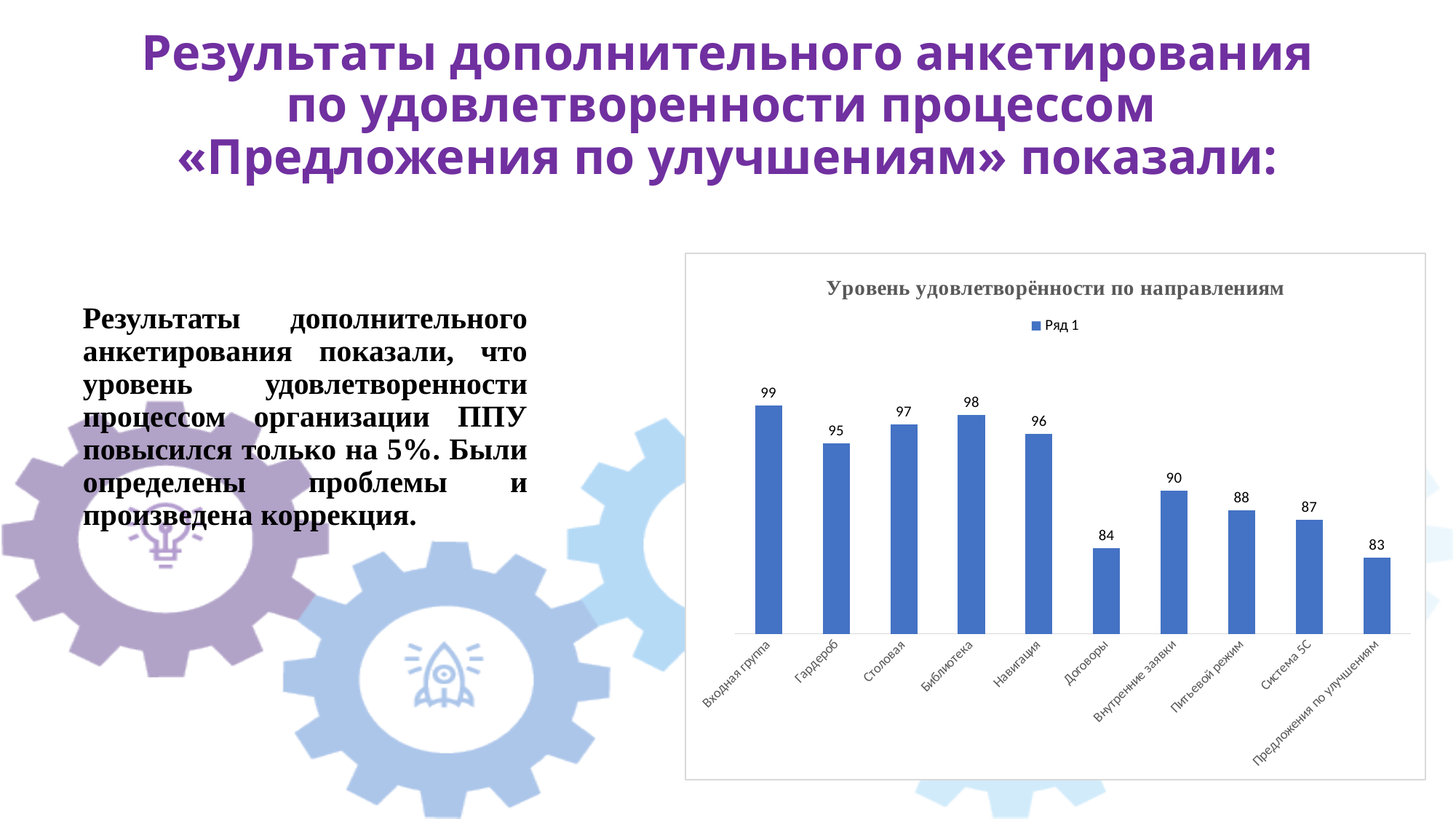
What is the difference between the values for Входная группа and Предложения по улучшениям? 16 Which is larger, the value for Библиотека or the value for Навигация? Библиотека How many series does the legend list? 1 What is the title of the chart? Уровень удовлетворённости по направлениям What is the value for Договоры? 84 What is the value for Предложения по улучшениям? 83 Which category has the highest value? Входная группа Which category has the lowest value? Предложения по улучшениям What kind of chart is shown on the slide? Bar chart How many categories are shown in the chart? 10 What is the name of the series in the legend? Ряд 1 What is the value for Входная группа? 99